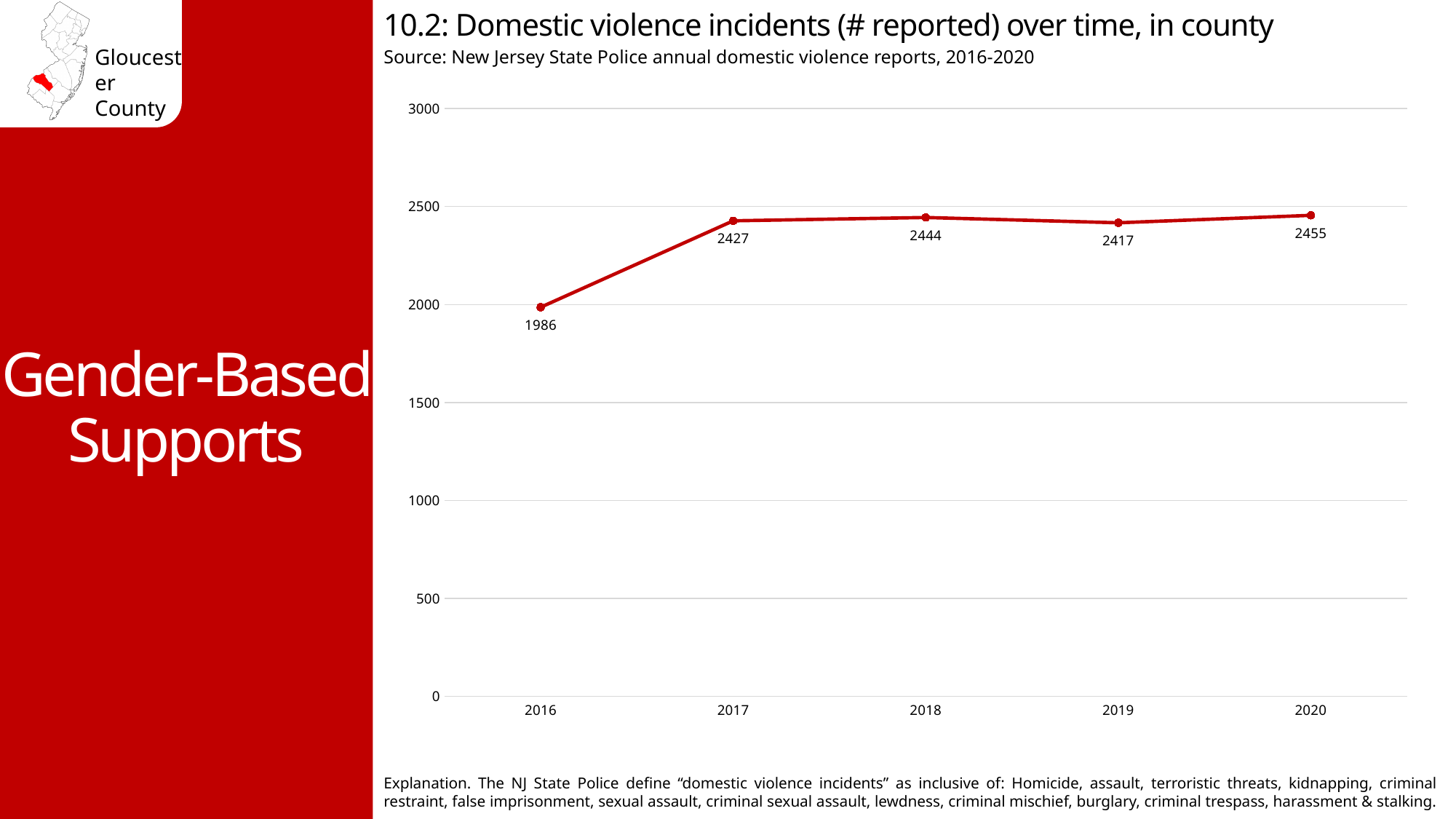
How many domestic violence incidents were reported in 2020? 2455 How many years are plotted on the chart? 5 What is the source of the data shown in the chart? New Jersey State Police annual domestic violence reports, 2016-2020 Which year had the lowest number of reported domestic violence incidents? 2016 Is the value for 2016 greater or less than 2000? less What kind of chart is shown on the slide? line chart What is the difference between the number of incidents reported in 2017 and in 2016? 441 How many domestic violence incidents were reported in 2016? 1986 Which year had the highest number of reported domestic violence incidents? 2020 What is the difference between the number of incidents reported in 2018 and in 2019? 27 How many domestic violence incidents were reported in 2018? 2444 Which year had more reported incidents, 2017 or 2019? 2017